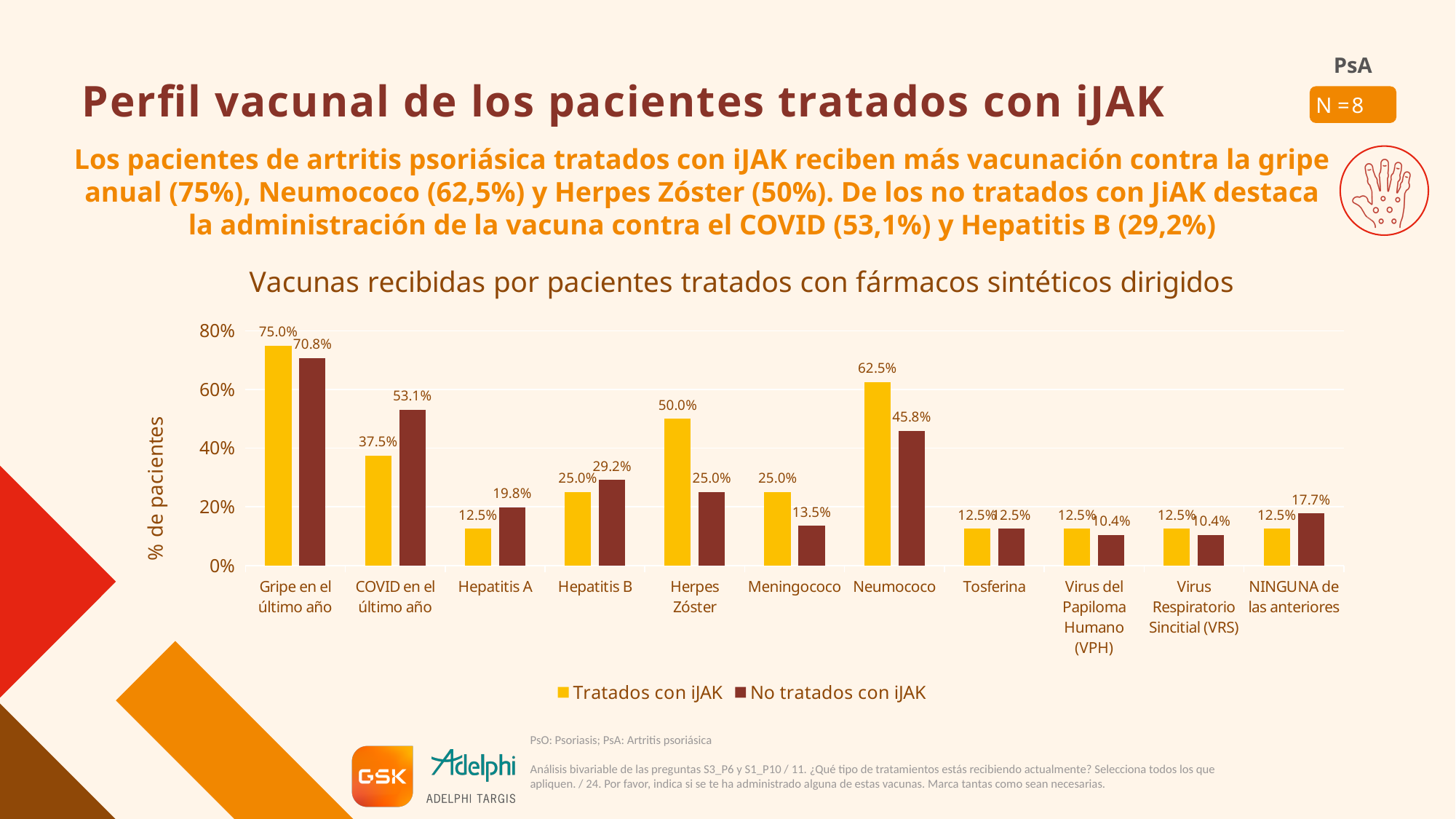
Which category has the lowest value for the 'No tratados con iJAK' series? Virus del Papiloma Humano (VPH) and Virus Respiratorio Sincitial (VRS) (both 10.4%) What percentage of patients not treated with iJAK received the Hepatitis B vaccine? 29.2% What type of chart is shown on the slide? Bar chart How many series does the legend list? 2 Is the 'No tratados con iJAK' value for Meningococo greater or less than 20%? less What percentage of patients treated with iJAK received the flu vaccine in the last year (Gripe en el último año)? 75.0% How many vaccine categories are shown on the x axis? 11 For Herpes Zóster, which series has the larger value: 'Tratados con iJAK' or 'No tratados con iJAK'? Tratados con iJAK Which category has the highest value for the 'Tratados con iJAK' series? Gripe en el último año What is the title of the chart? Vacunas recibidas por pacientes tratados con fármacos sintéticos dirigidos What is the value for 'No tratados con iJAK' for COVID en el último año? 53.1% What is the difference between the 'Tratados con iJAK' and 'No tratados con iJAK' values for Neumococo? 16.7 percentage points